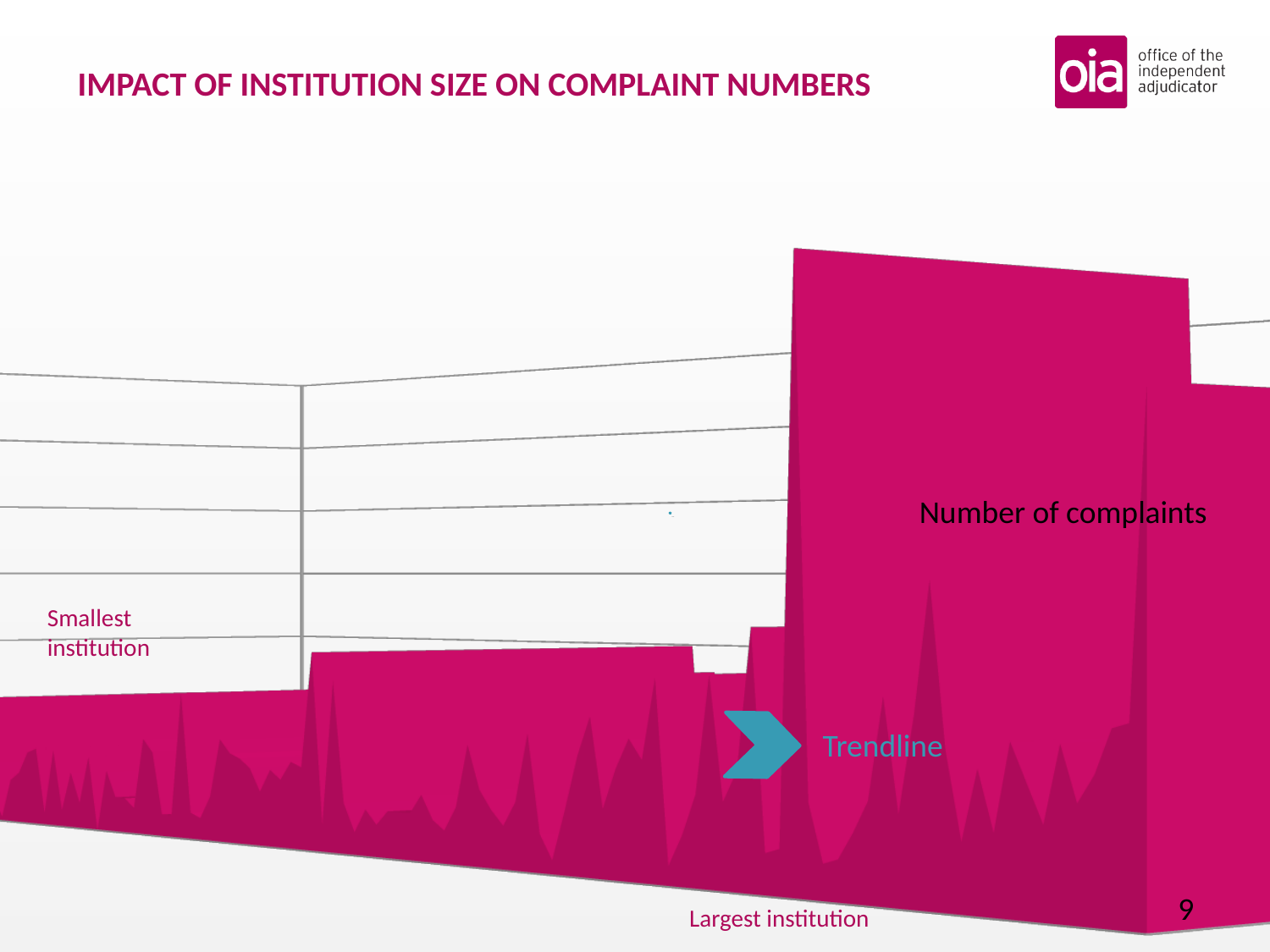
Which end of the x axis, smallest institution or largest institution, shows the higher number of complaints? Largest institution At which end of the chart is the number of complaints lowest? Smallest institution What kind of chart is shown on the slide? Area chart What does the label on the large pink area of the chart say the plotted values represent? Number of complaints What is the title of the chart on the slide? IMPACT OF INSTITUTION SIZE ON COMPLAINT NUMBERS Do the number of complaints rise or fall as institution size increases from the smallest to the largest institution? Rise